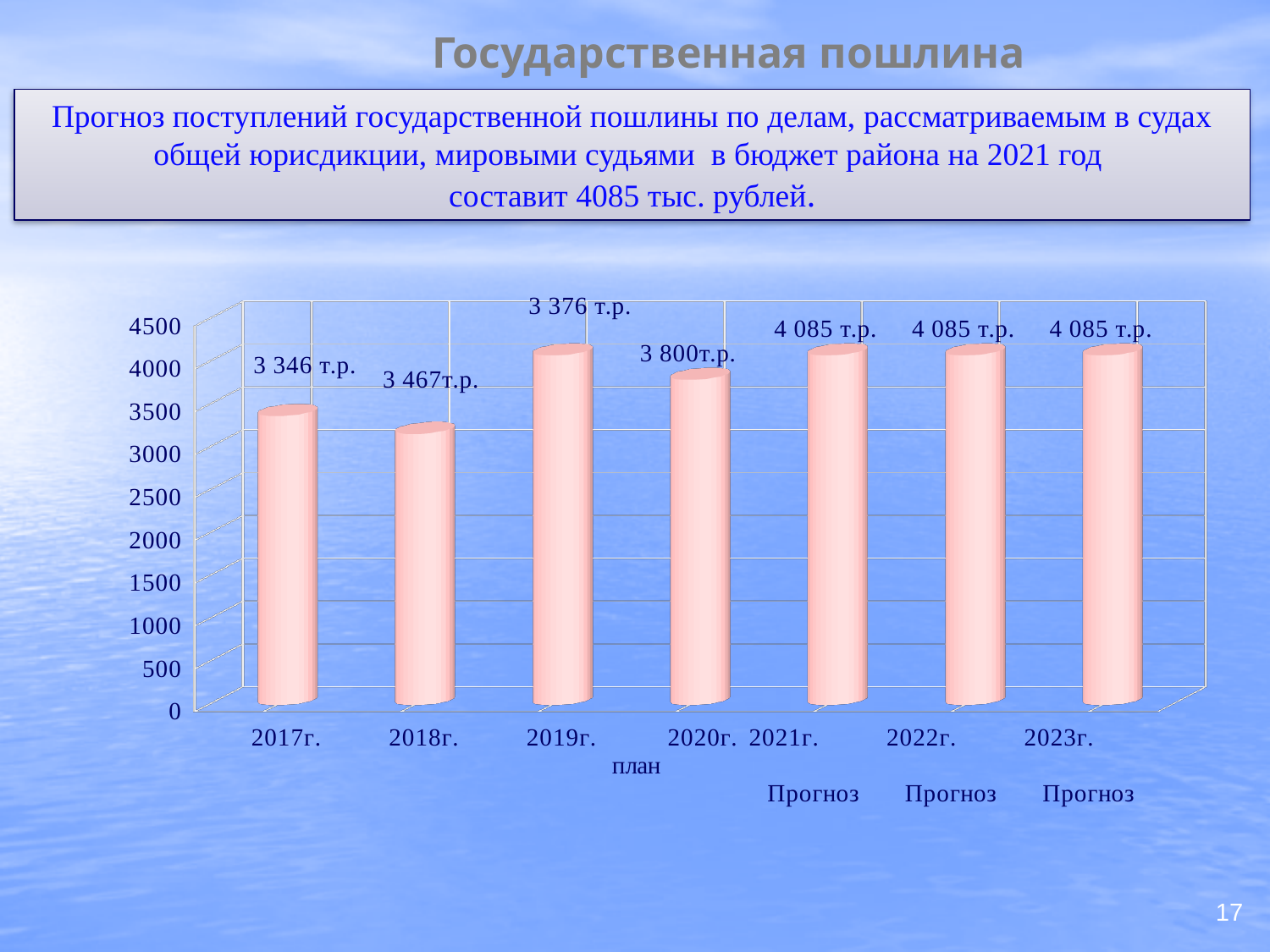
What is the forecast value shown for 2022г.? 4 085 т.р. What is the difference between the value for 2021г. Прогноз and the value for 2020г. план? 285 т.р. Is the value for 2017г. greater or less than 3500? less Which is larger, the value for 2020г. план or the value for 2017г.? 2020г. план How many years (categories) are shown on the x axis? 7 What is the value shown for 2020г. план? 3 800т.р. What is the difference between the value for 2021г. Прогноз and the value for 2017г.? 739 т.р. Is the value for 2021г. Прогноз greater or less than 4000? greater Do the forecast values change from 2021г. to 2023г.? No, they stay the same at 4 085 т.р. What is the value shown for 2019г.? 3 376 т.р. What is the value shown for 2017г.? 3 346 т.р. What kind of chart is shown on the slide? bar chart